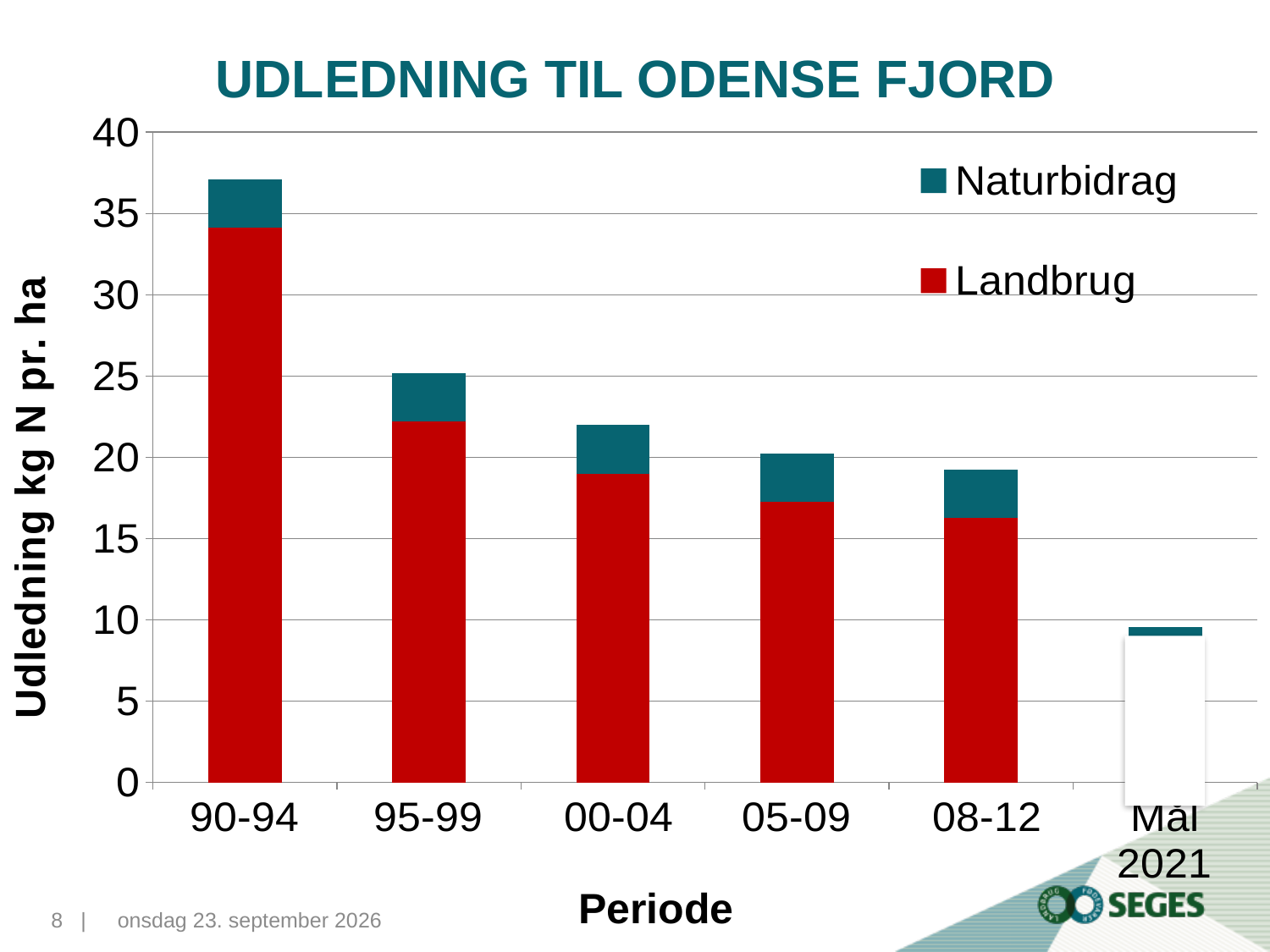
Which category has the lowest total bar? Mål 2021 What kind of chart is shown on the slide? stacked bar chart Which period has the highest total bar? 90-94 How many periods are shown on the x axis? 6 Which series is shown in red? Landbrug Is the total value for 95-99 greater or less than 20? greater Which is larger, the total bar for 95-99 or the total bar for 05-09? 95-99 What is the title of the chart? UDLEDNING TIL ODENSE FJORD Do the total bars rise or fall from 90-94 to 08-12? fall How many series does the legend list? 2 Is the total value for 90-94 greater or less than 35? greater Is the Landbrug value for 08-12 greater or less than 20? less